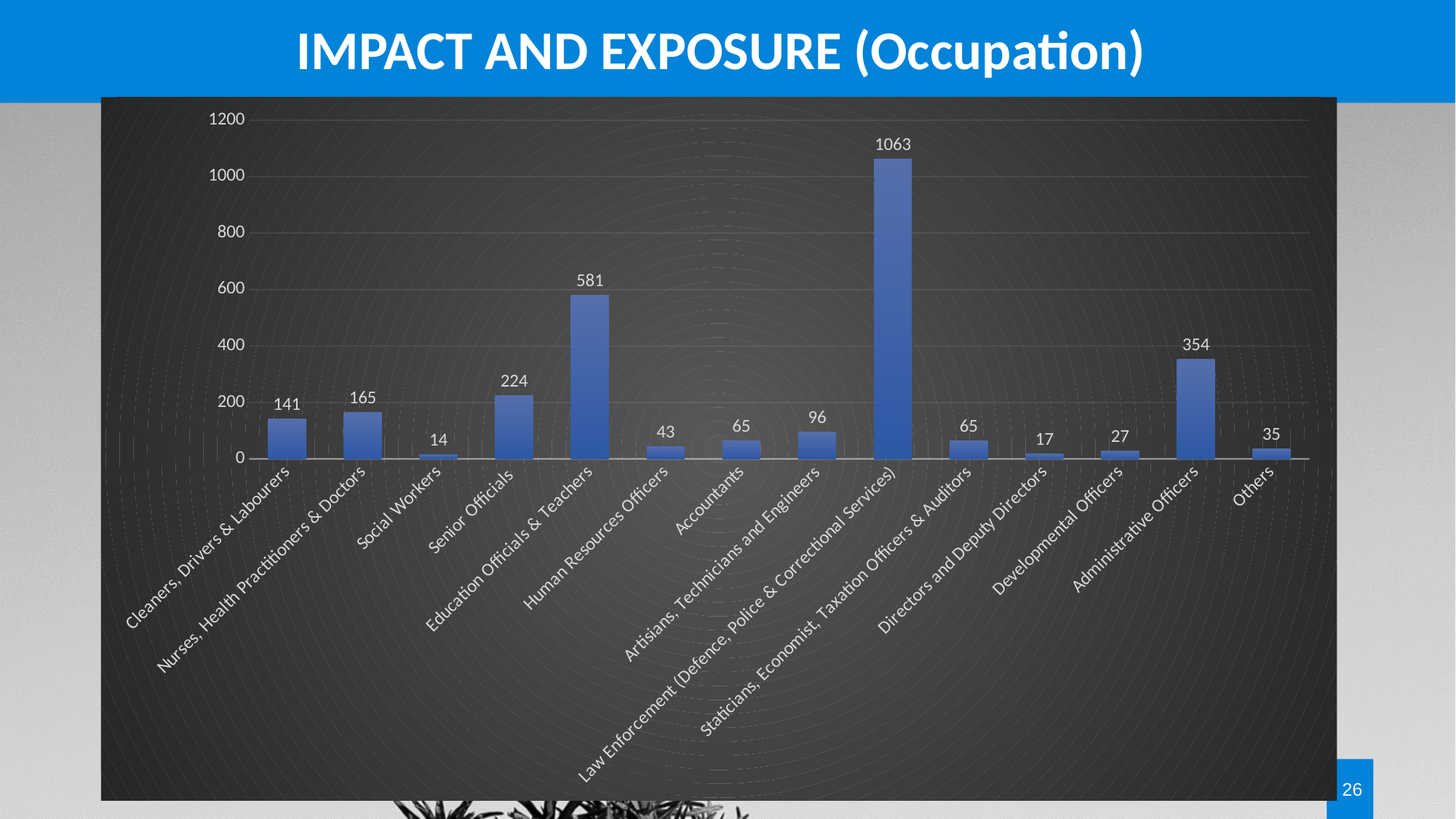
What is the value for Education Officials & Teachers? 581 What is the title of the slide? IMPACT AND EXPOSURE (Occupation) What is the difference between the values for Law Enforcement (Defence, Police & Correctional Services) and Education Officials & Teachers? 482 What is the value for Administrative Officers? 354 What is the value for Social Workers? 14 Is the value for Administrative Officers greater or less than 400? less Which occupation has the lowest value? Social Workers Which occupation has the highest value? Law Enforcement (Defence, Police & Correctional Services) What kind of chart is shown on the slide? bar chart What is the value for Law Enforcement (Defence, Police & Correctional Services)? 1063 How many occupation categories are shown on the chart? 14 Which is larger, the value for Senior Officials or the value for Nurses, Health Practitioners & Doctors? Senior Officials